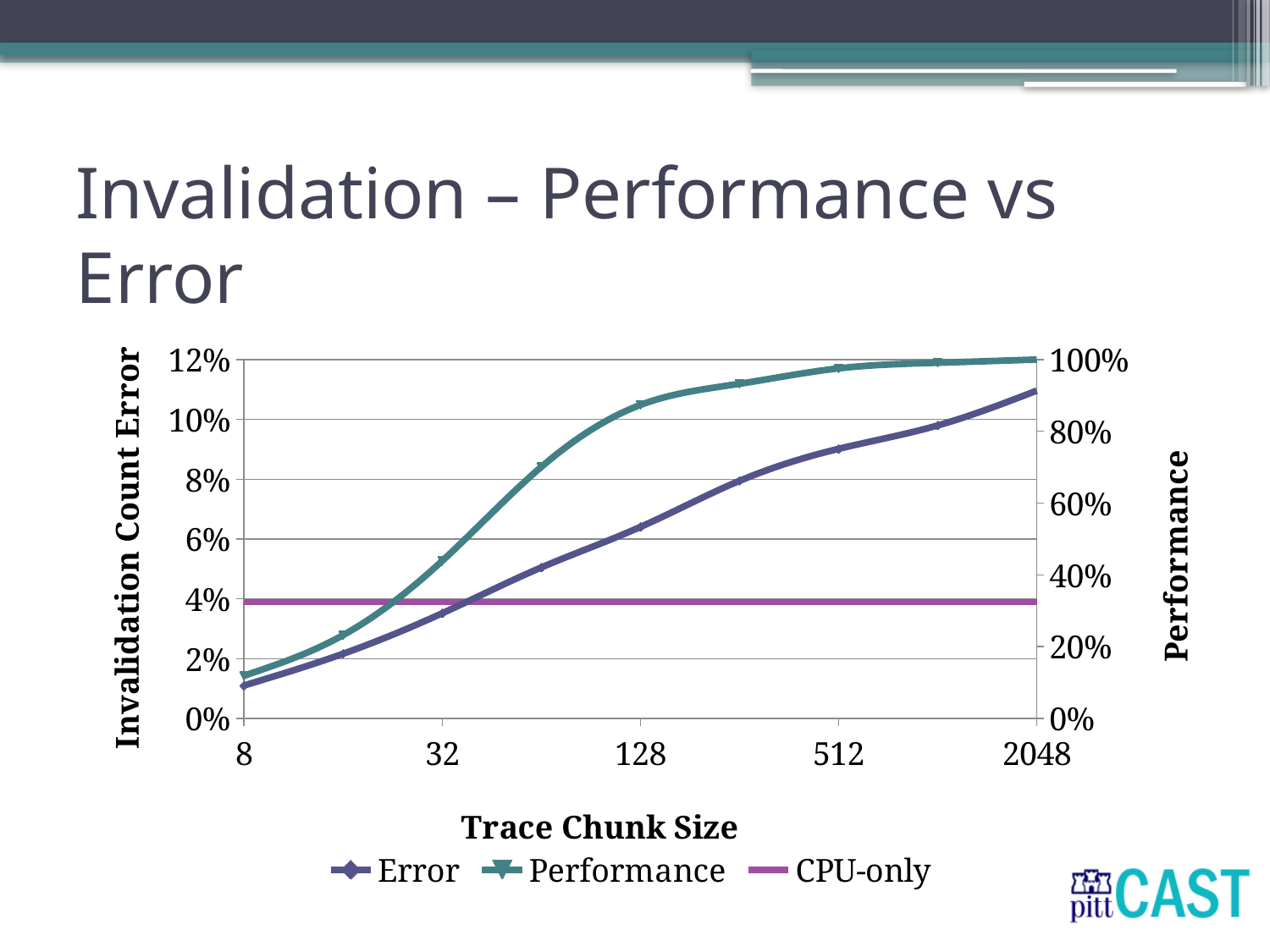
At which trace chunk size is the Error series highest? 2048 Is the Error value at a trace chunk size of 2048 greater or less than 10%? greater Is the Performance value at a trace chunk size of 32 greater or less than 60%? less What kind of chart is shown on the slide? line chart Is the Performance value at a trace chunk size of 128 greater or less than 80%? greater What is the title of the left y axis? Invalidation Count Error At which trace chunk size is the Performance series lowest? 8 How many series does the legend list? 3 What is the title of the x axis? Trace Chunk Size Does the Error series rise or fall as the trace chunk size increases? rise Does the Performance series rise or fall as the trace chunk size increases? rise